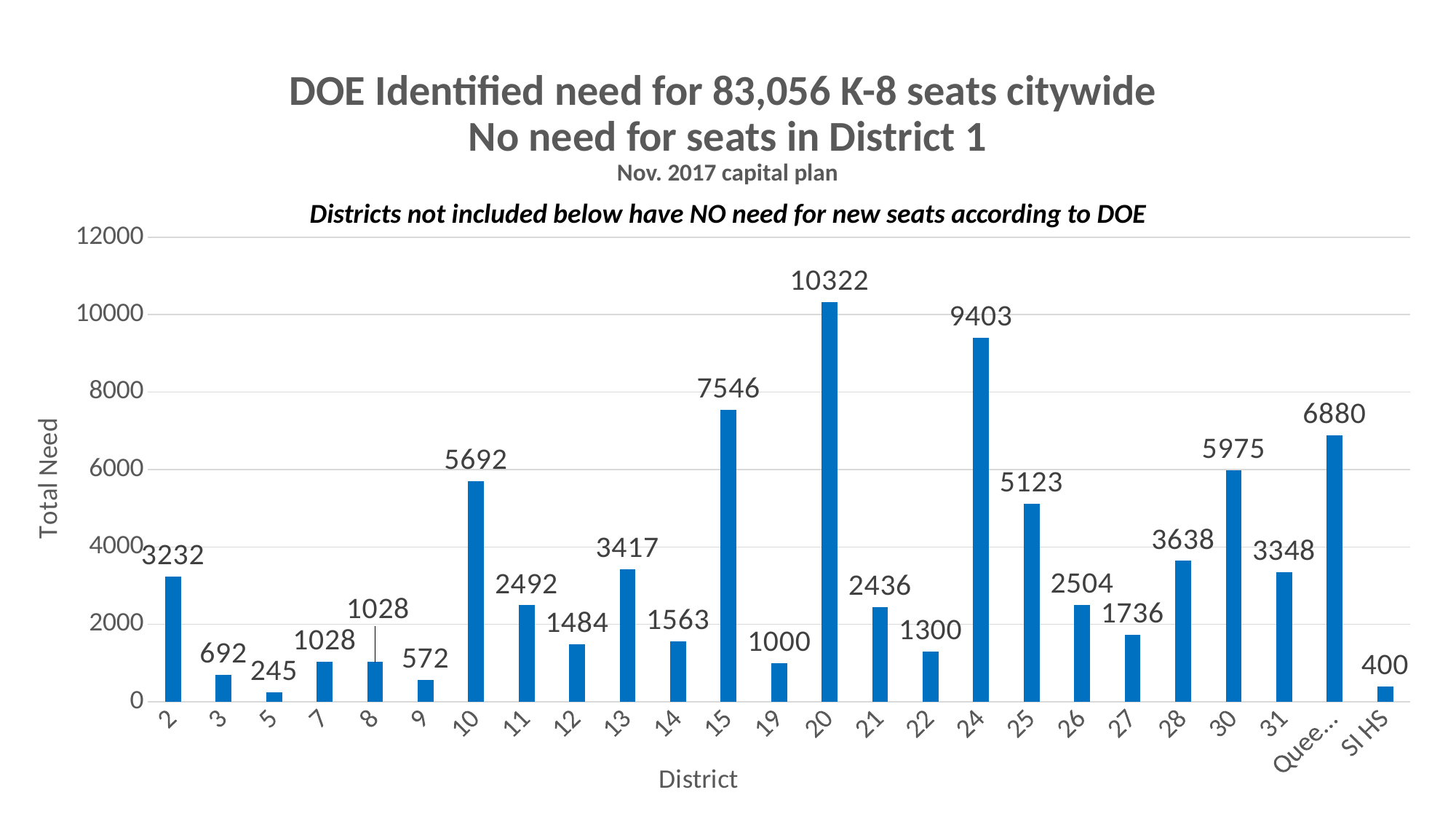
Which district has the lowest total need? 5 What is the label of the y axis? Total Need What kind of chart is shown on the slide? bar chart Is the total need for District 28 greater or less than 4000? less Which has a larger total need, District 30 or District 25? 30 What is the difference in total need between District 15 and District 10? 1854 What is the total need for District 20? 10322 What is the total need for SI HS? 400 What is the difference in total need between District 20 and District 24? 919 Which district has the highest total need? 20 What is the total need for District 15? 7546 How many districts/categories are shown on the x axis? 25